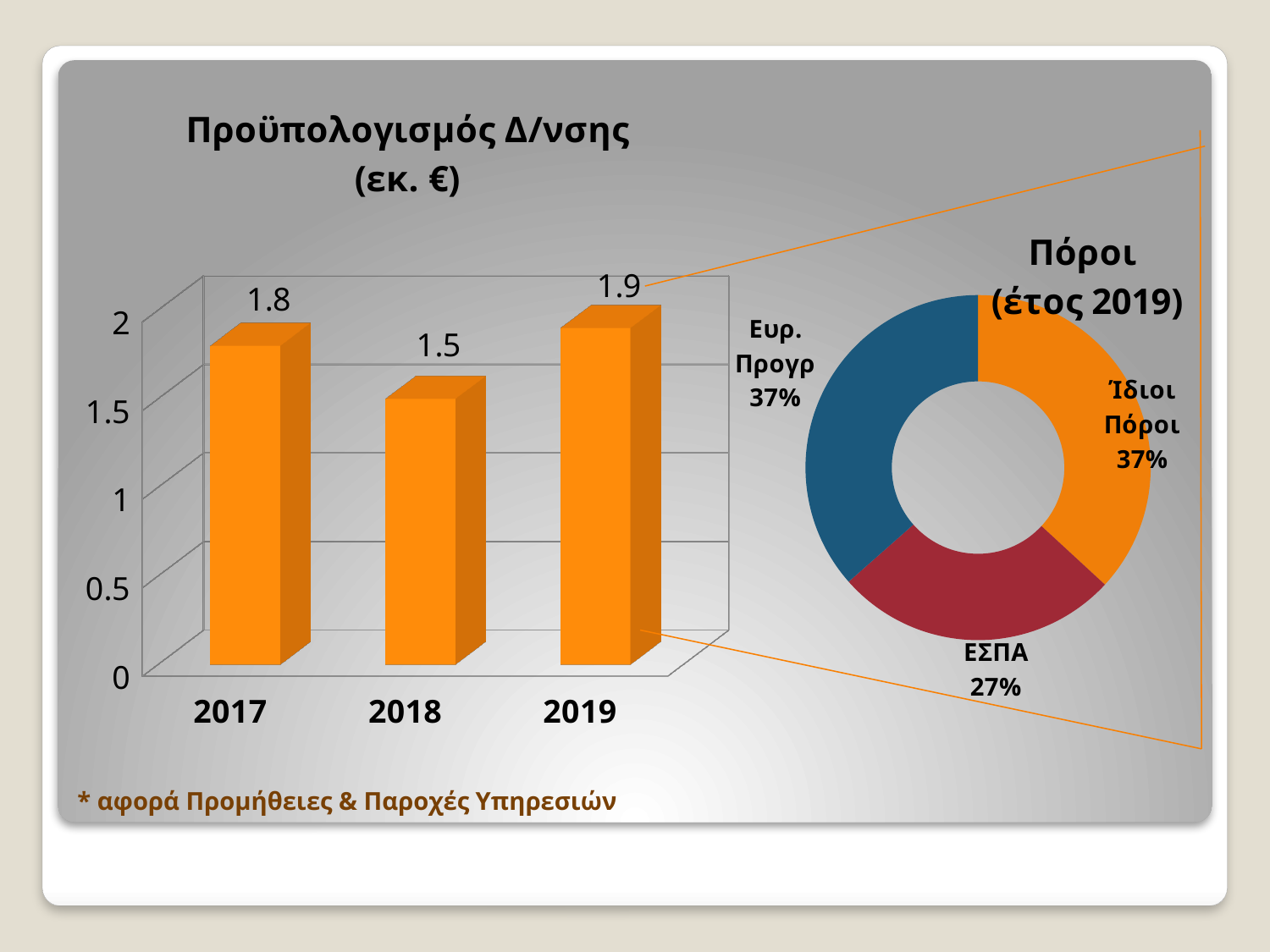
In the 'Προϋπολογισμός Δ/νσης (εκ. €)' chart, what is the value for 2018? 1.5 In the 'Πόροι (έτος 2019)' chart, what share does ΕΣΠΑ have? 27% In the 'Πόροι (έτος 2019)' chart, what share does Ίδιοι Πόροι have? 37% How many categories are shown in the 'Πόροι (έτος 2019)' chart? 3 In the 'Προϋπολογισμός Δ/νσης (εκ. €)' chart, what is the difference between the 2019 and 2018 values? 0.4 In the 'Προϋπολογισμός Δ/νσης (εκ. €)' chart, which is larger, the value for 2017 or for 2018? 2017 In the 'Προϋπολογισμός Δ/νσης (εκ. €)' chart, what is the value for 2019? 1.9 In the 'Προϋπολογισμός Δ/νσης (εκ. €)' chart, which year has the lowest value? 2018 How many years are shown in the 'Προϋπολογισμός Δ/νσης (εκ. €)' chart? 3 In the 'Προϋπολογισμός Δ/νσης (εκ. €)' chart, which year has the highest value? 2019 What kind of chart is the 'Προϋπολογισμός Δ/νσης (εκ. €)' chart? Bar chart In the 'Πόροι (έτος 2019)' chart, which category has the smallest share? ΕΣΠΑ